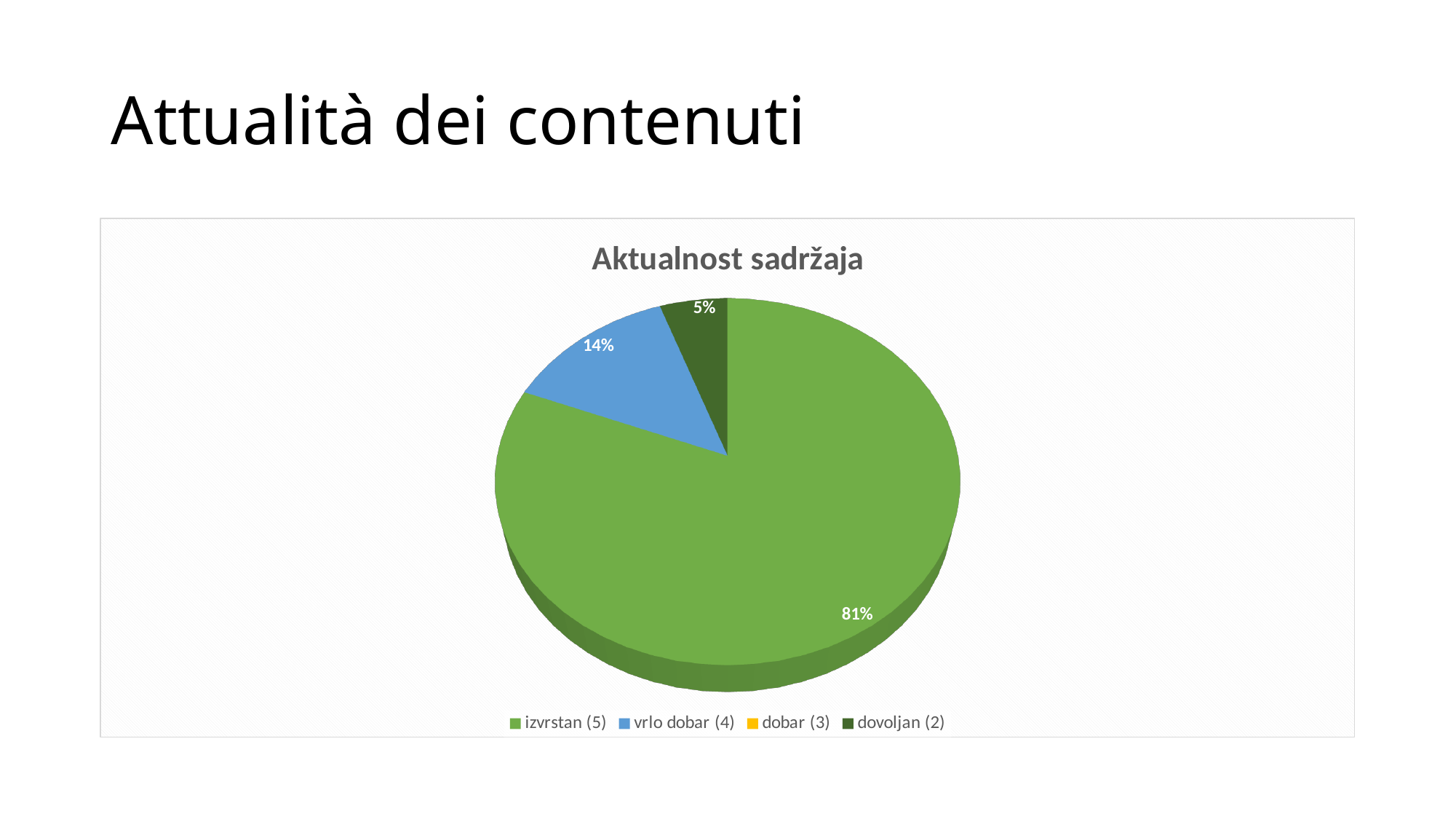
What colour is the slice for vrlo dobar (4)? blue What is the difference in percentage points between the izvrstan (5) slice and the vrlo dobar (4) slice? 67 What share of the pie does dovoljan (2) have? 5% Which of the labelled slices is the smallest? dovoljan (2) What share of the pie does vrlo dobar (4) have? 14% How many slices with a percentage label are visible in the pie? 3 What is the title of the chart? Aktualnost sadržaja Which slice is larger, vrlo dobar (4) or dovoljan (2)? vrlo dobar (4) What share of the pie does izvrstan (5) have? 81% Which category has the largest slice of the pie? izvrstan (5) What type of chart is shown on the slide? pie chart How many entries does the legend list? 4